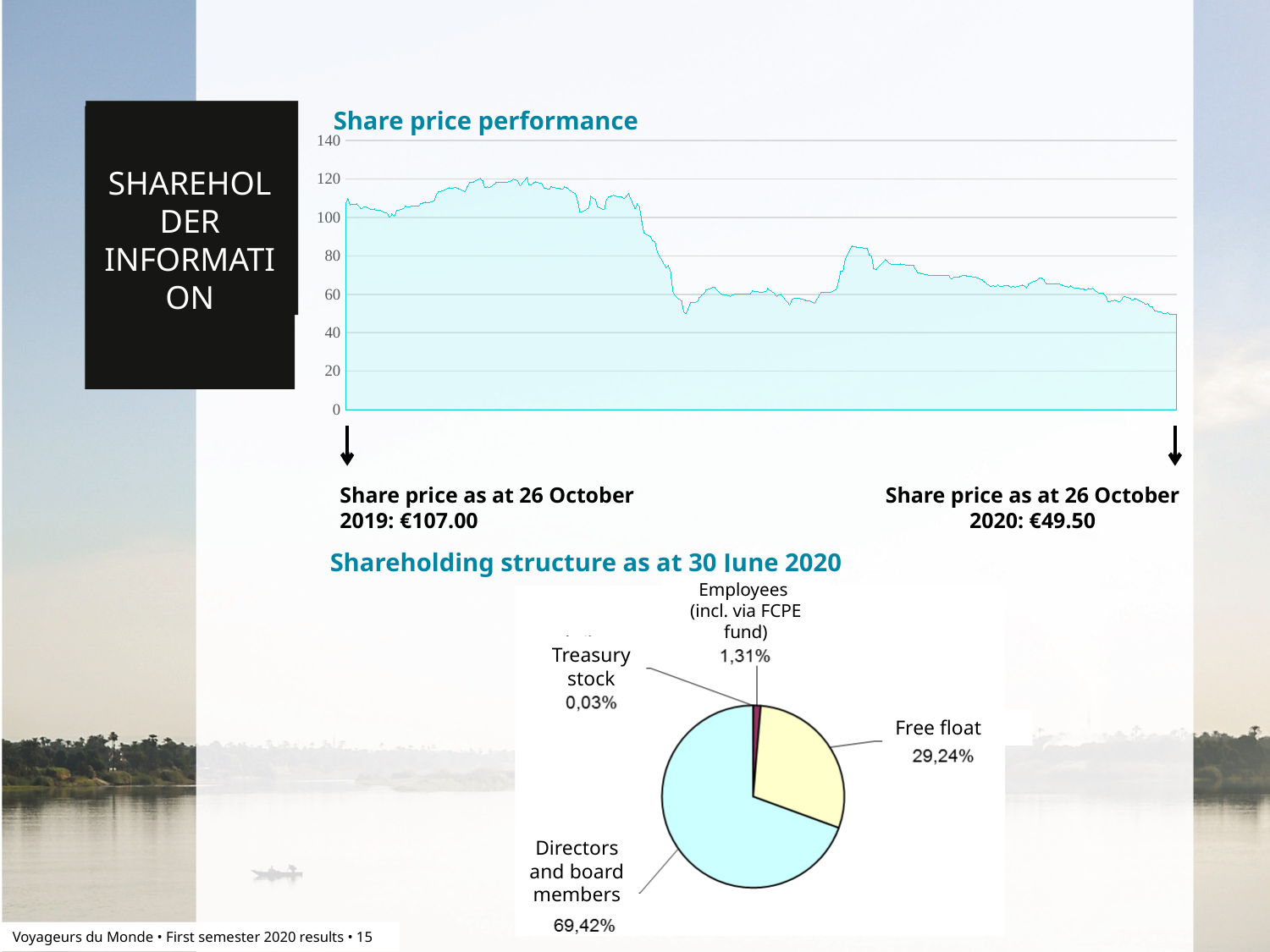
In the Shareholding structure pie chart, what share is held as free float? 29,24% In the Shareholding structure pie chart, what share is held by employees (incl. via FCPE fund)? 1,31% In the Share price performance chart, what was the share price as at 26 October 2020? €49.50 In the Shareholding structure pie chart, which category holds the smallest share? Treasury stock In the Share price performance chart, what was the share price as at 26 October 2019? €107.00 In the Share price performance chart, by how much did the share price fall between 26 October 2019 and 26 October 2020? €57.50 How many slices does the Shareholding structure pie chart have? 4 What kind of chart is used for the Shareholding structure as at 30 June 2020? Pie chart In the Shareholding structure pie chart, what share is treasury stock? 0,03% In the Shareholding structure pie chart, which category holds the largest share? Directors and board members In the Share price performance chart, does the share price overall rise or fall from left to right? Fall In the Shareholding structure pie chart, what share is held by directors and board members? 69,42%